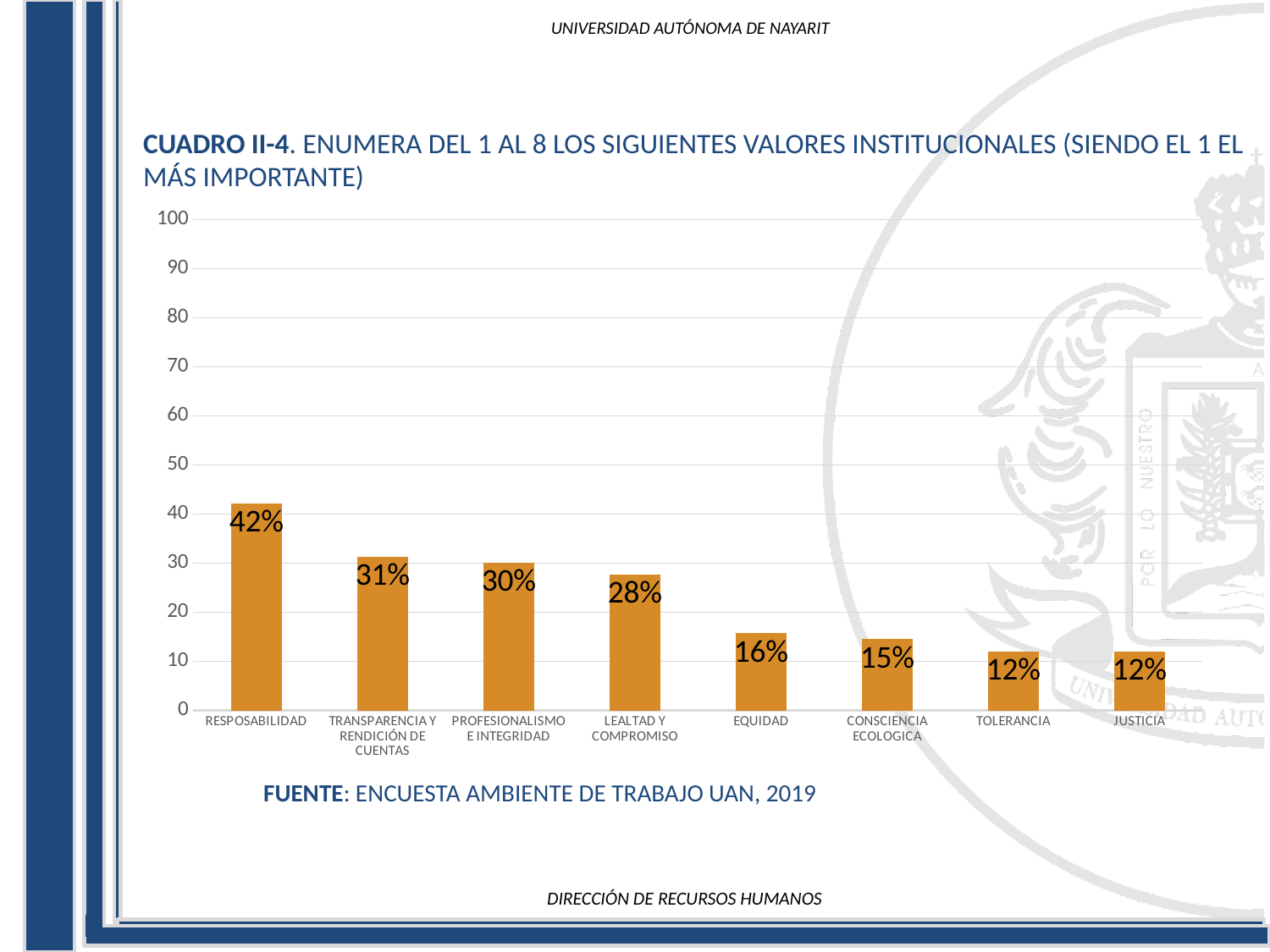
Is the value for EQUIDAD greater or less than 20? less What is the value for RESPOSABILIDAD? 42% Which category has the highest value? RESPOSABILIDAD Do the values rise or fall from left to right along the x axis? fall What is the value for TOLERANCIA? 12% How many categories are shown on the x axis? 8 What is the value for CONSCIENCIA ECOLOGICA? 15% Which is larger, the value for TRANSPARENCIA Y RENDICIÓN DE CUENTAS or the value for PROFESIONALISMO E INTEGRIDAD? TRANSPARENCIA Y RENDICIÓN DE CUENTAS What is the difference between the values for RESPOSABILIDAD and TRANSPARENCIA Y RENDICIÓN DE CUENTAS? 11 percentage points What is the value for LEALTAD Y COMPROMISO? 28% What source is cited below the chart? ENCUESTA AMBIENTE DE TRABAJO UAN, 2019 What kind of chart is shown on the slide? bar chart